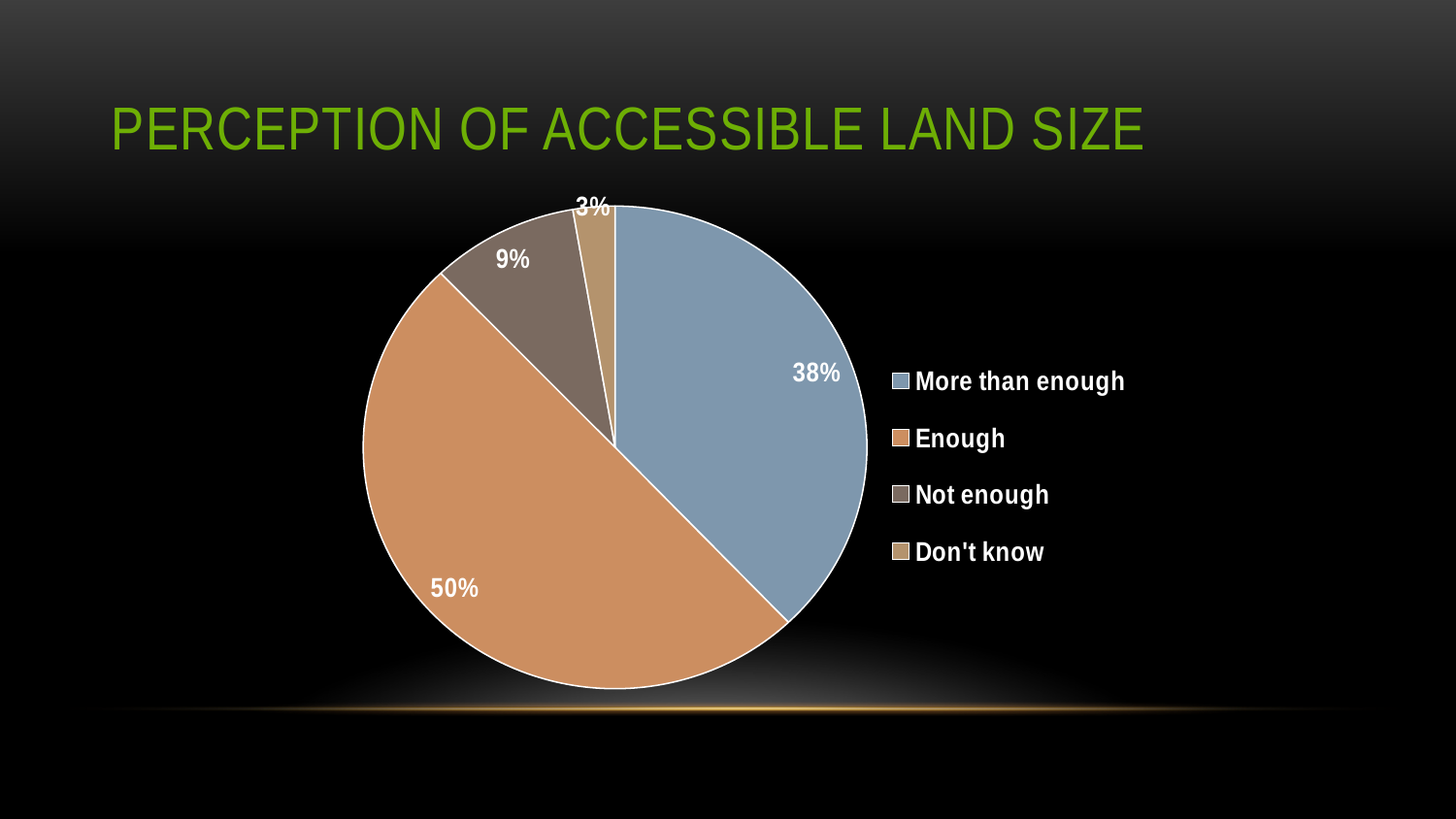
What percentage of respondents said the accessible land size is "Enough"? 50% What is the difference in percentage points between "Enough" and "More than enough"? 12 What is the title of the chart on the slide? Perception of Accessible Land Size Which category has the largest share of the pie? Enough Which is larger, the share for "Not enough" or the share for "Don't know"? Not enough What percentage of respondents said the accessible land size is "More than enough"? 38% How many categories are shown in the pie chart? 4 What percentage of respondents said the accessible land size is "Not enough"? 9% Which category has the smallest share of the pie? Don't know What type of chart is shown on the slide? Pie chart What percentage of respondents answered "Don't know"? 3% Which colour represents "More than enough" in the legend? Blue